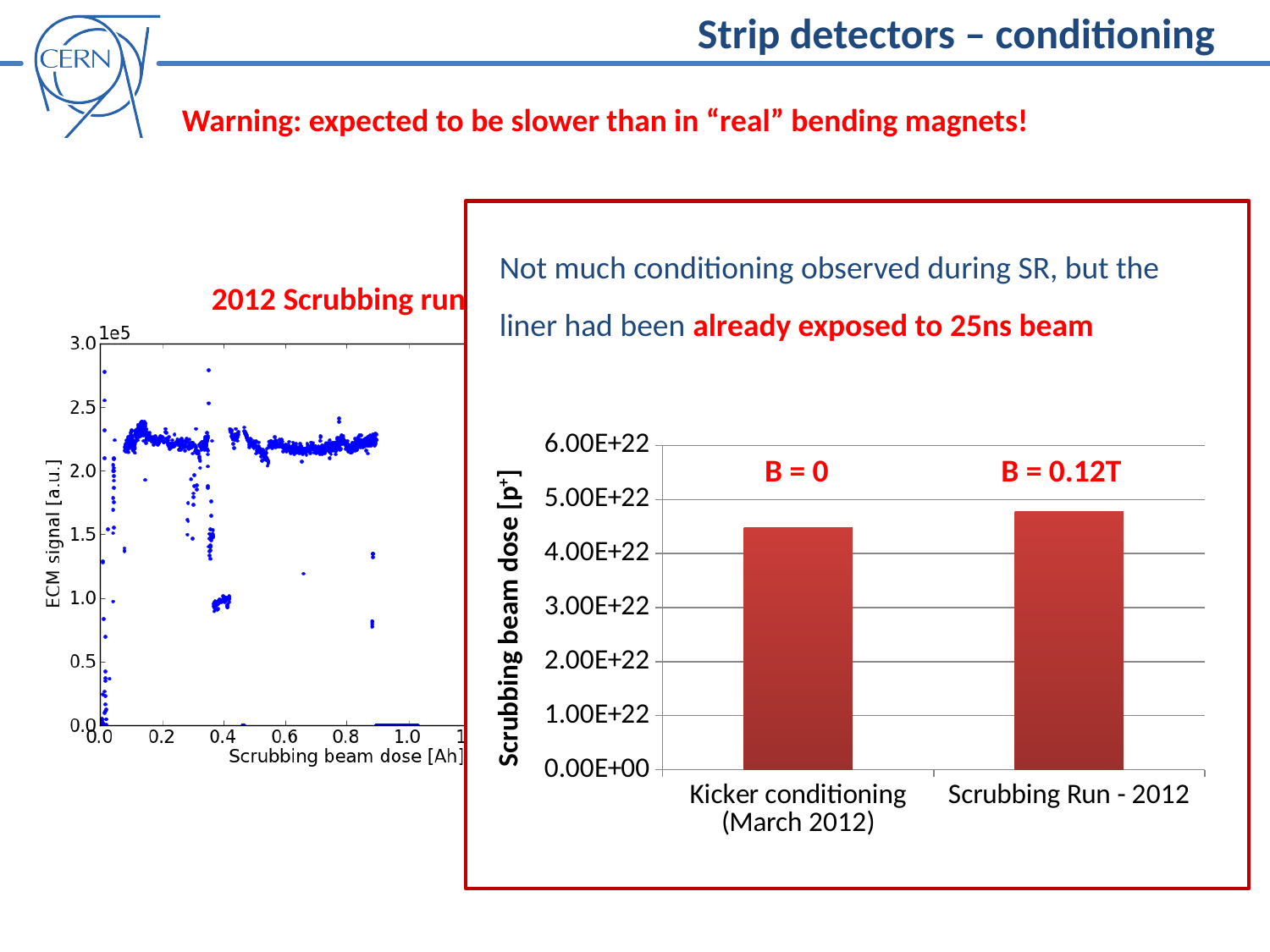
In the bar chart on the right, which category has the higher scrubbing beam dose? Scrubbing Run - 2012 In the bar chart on the right, is the value for Scrubbing Run - 2012 greater or less than 4.00E+22? greater What kind of chart is the 2012 Scrubbing run plot on the left? scatter plot What is the x-axis label of the 2012 Scrubbing run plot on the left? Scrubbing beam dose [Ah] How many categories are shown in the bar chart on the right? 2 What kind of chart is shown on the right side of the slide? bar chart What is the y-axis label of the bar chart on the right? Scrubbing beam dose [p+] In the bar chart on the right, is the value for Kicker conditioning (March 2012) greater or less than 4.00E+22? greater In the bar chart on the right, is the value for Kicker conditioning (March 2012) greater or less than 5.00E+22? less In the bar chart on the right, is the bar for Scrubbing Run - 2012 larger or smaller than the bar for Kicker conditioning (March 2012)? larger In the bar chart on the right, which category has the lower scrubbing beam dose? Kicker conditioning (March 2012)